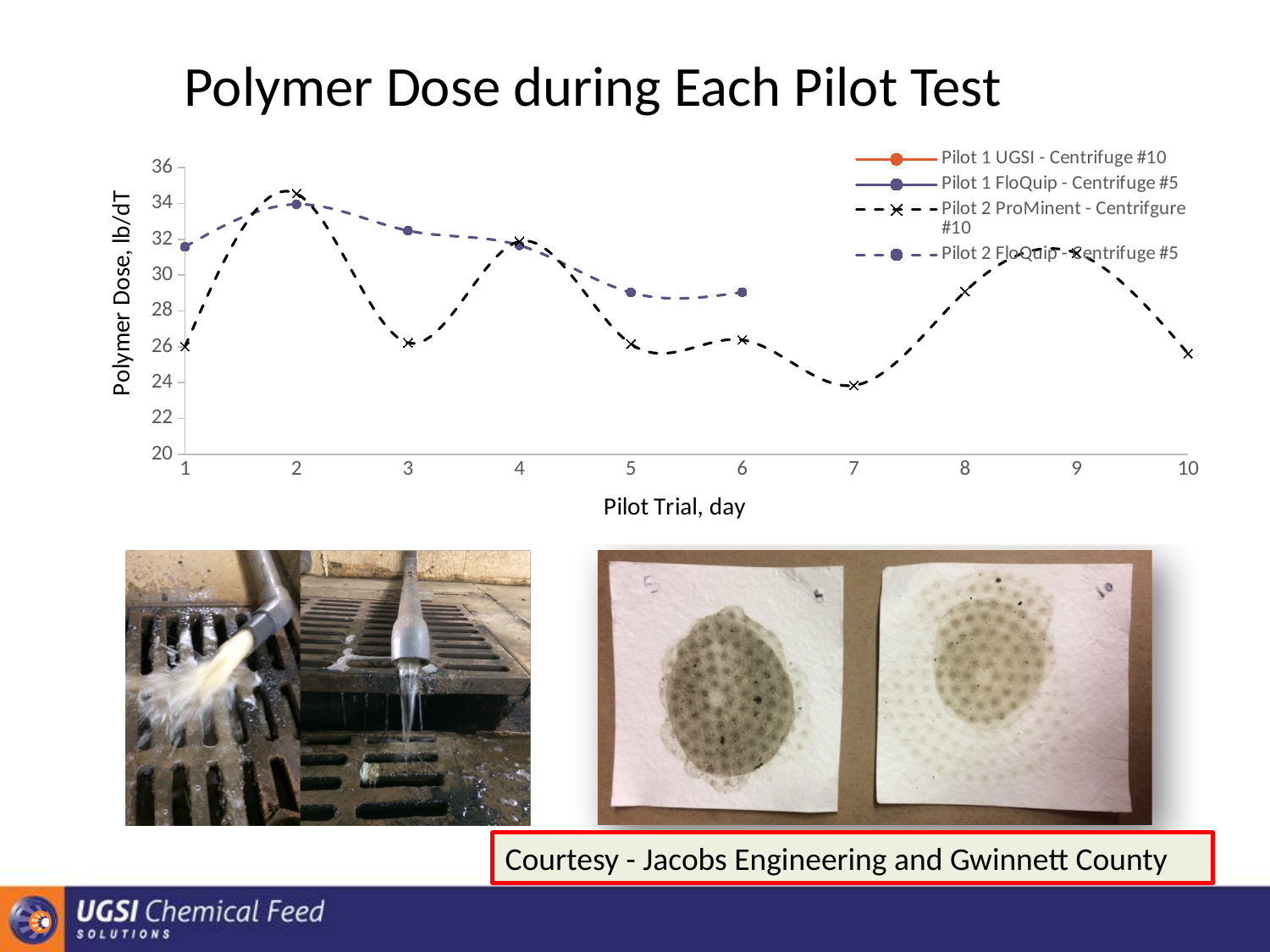
On which pilot trial day does the Pilot 2 ProMinent - Centrifgure #10 series reach its lowest value? 7 On day 3, which series has the larger value: Pilot 2 FloQuip - Centrifuge #5 or Pilot 2 ProMinent - Centrifgure #10? Pilot 2 FloQuip - Centrifuge #5 How many series does the chart legend list? 4 What kind of chart is shown on the slide? line chart On which pilot trial day does the Pilot 2 FloQuip - Centrifuge #5 series reach its highest value? 2 On which pilot trial day does the Pilot 2 ProMinent - Centrifgure #10 series reach its highest value? 2 Is the value for Pilot 2 FloQuip - Centrifuge #5 on day 1 greater or less than 30? greater Is the value for Pilot 2 ProMinent - Centrifgure #10 on day 2 greater or less than 34? greater What is the label of the vertical axis? Polymer Dose, lb/dT What is the title of the chart? Polymer Dose during Each Pilot Test Is the value for Pilot 2 ProMinent - Centrifgure #10 on day 10 greater or less than 26? less How many pilot trial days are marked along the x axis? 10